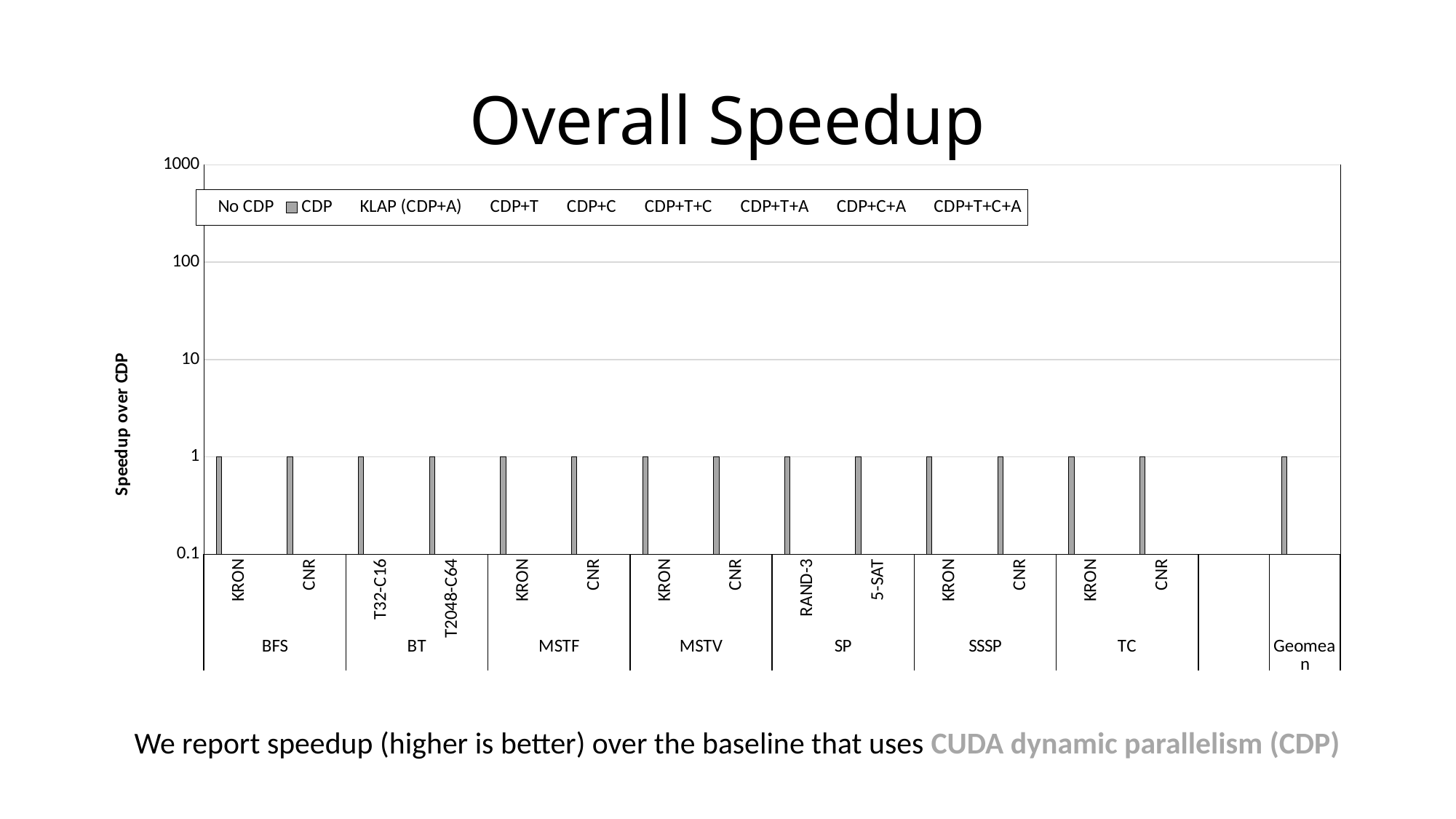
What kind of chart is shown on the slide? bar chart Is the CDP value for CNR under TC greater or less than 0.1? greater What is the CDP speedup value for KRON under BFS? 1 What is the CDP speedup value for Geomean? 1 What is the label of the y axis? Speedup over CDP What is the CDP speedup value for T32-C16 under BT? 1 How many series does the legend list? 9 What is the highest value shown on the y axis? 1000 Is the CDP value for RAND-3 under SP greater or less than 10? less How many CDP bars are plotted on the chart? 15 What is the title of the chart? Overall Speedup How many benchmark groups (excluding Geomean) are shown along the x axis? 7